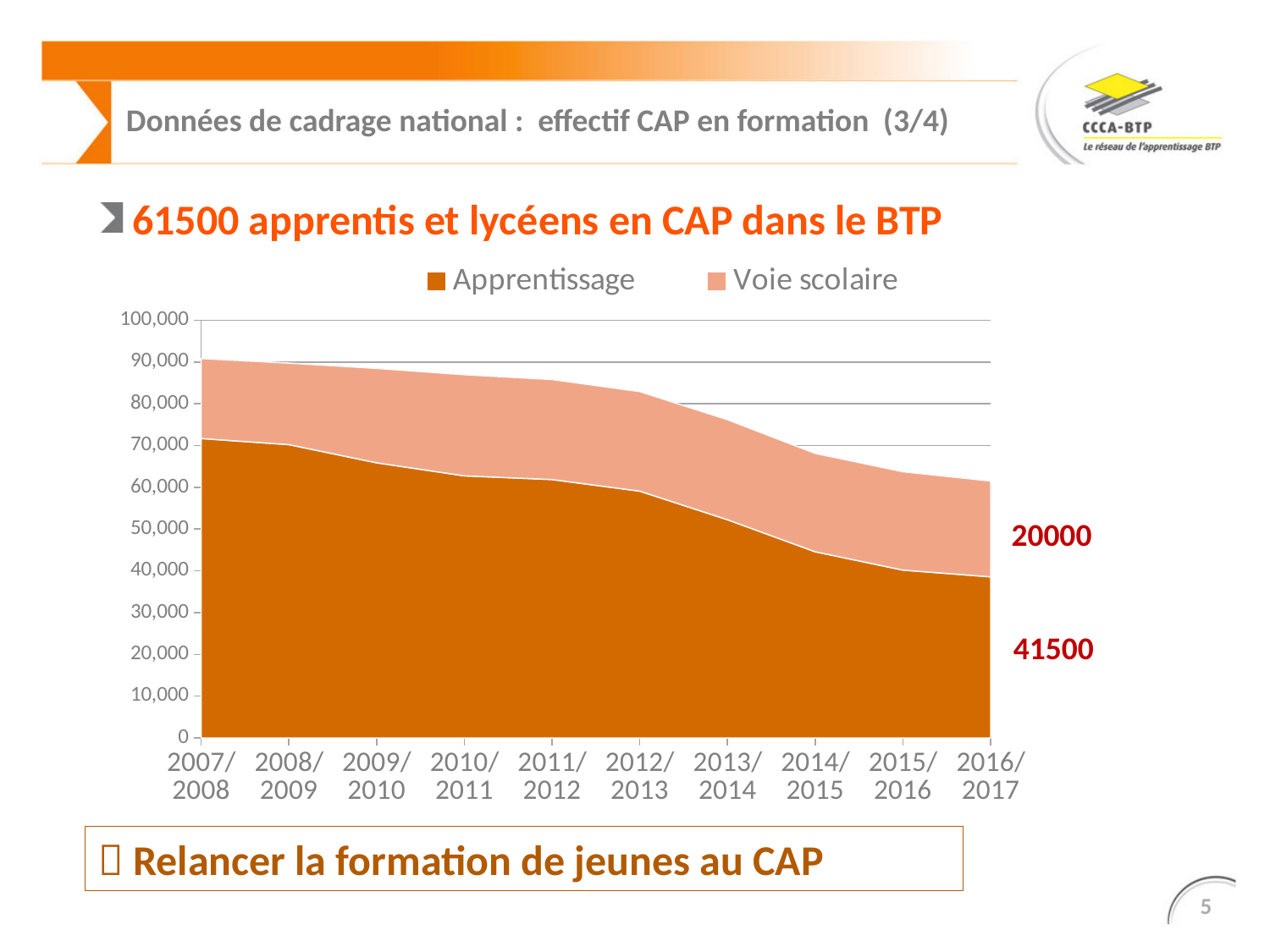
How many school years are shown on the x axis? 10 Is the value for Apprentissage in 2007/2008 greater or less than 60,000? greater Does the Apprentissage series rise or fall from 2007/2008 to 2016/2017? Fall How many series does the legend list? 2 Which school year has the highest value for Apprentissage? 2007/2008 What is the total of Apprentissage and Voie scolaire in 2016/2017? 61500 Which school year has the lowest value for Apprentissage? 2016/2017 Which series is shown in dark orange? Apprentissage What kind of chart is shown on the slide? Area chart In 2016/2017, which is larger, Apprentissage or Voie scolaire? Apprentissage